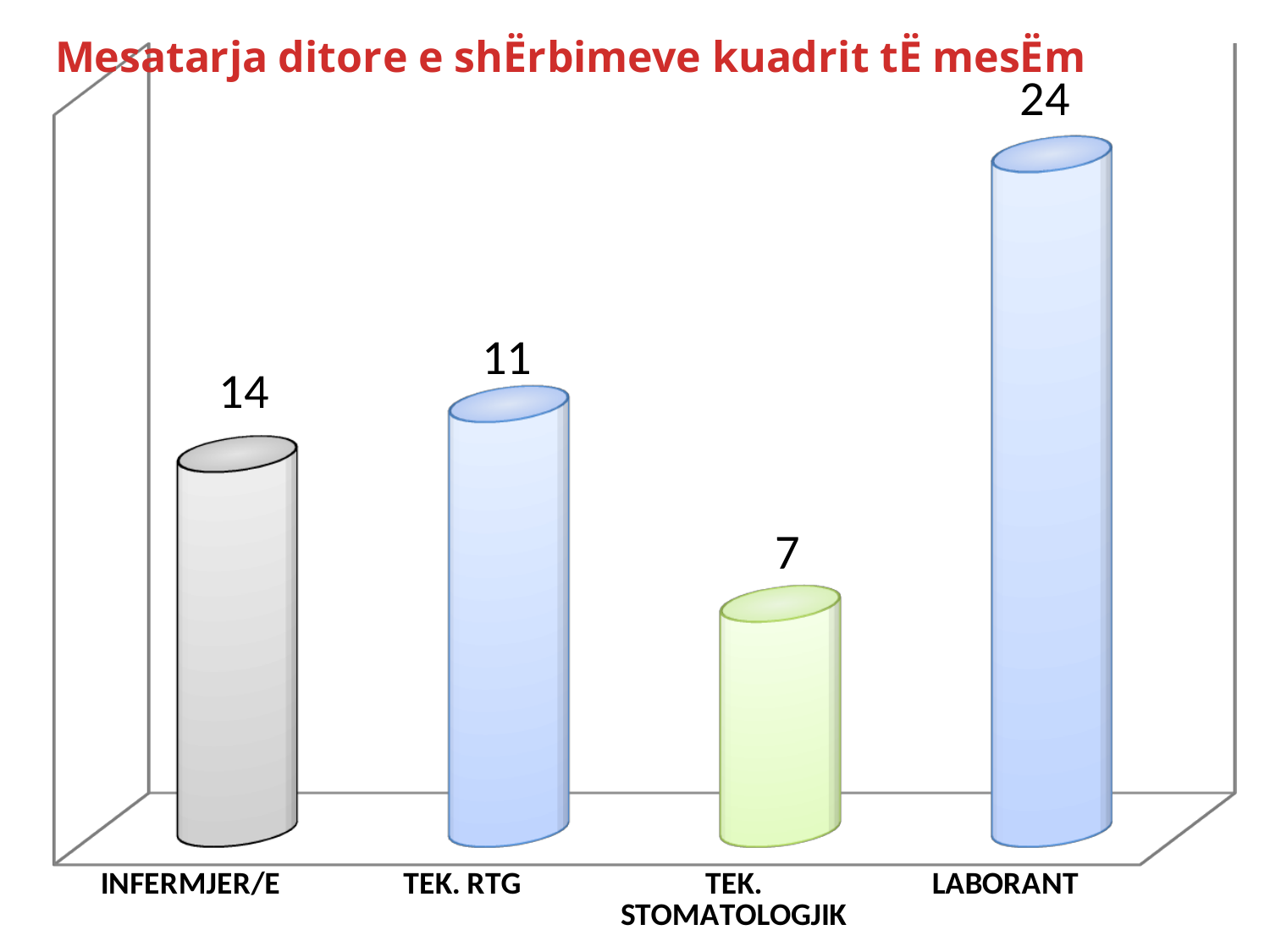
What is the title of the chart? Mesatarja ditore e shËrbimeve kuadrit tË mesËm What kind of chart is shown on the slide? Bar chart What is the difference between the values for TEK. RTG and TEK. STOMATOLOGJIK? 4 What is the value for LABORANT? 24 How many categories are shown on the chart? 4 Which category has the lowest value? TEK. STOMATOLOGJIK What is the value for TEK. STOMATOLOGJIK? 7 What is the value for TEK. RTG? 11 What is the difference between the values for LABORANT and INFERMJER/E? 10 What is the value for INFERMJER/E? 14 Which category has the highest value? LABORANT